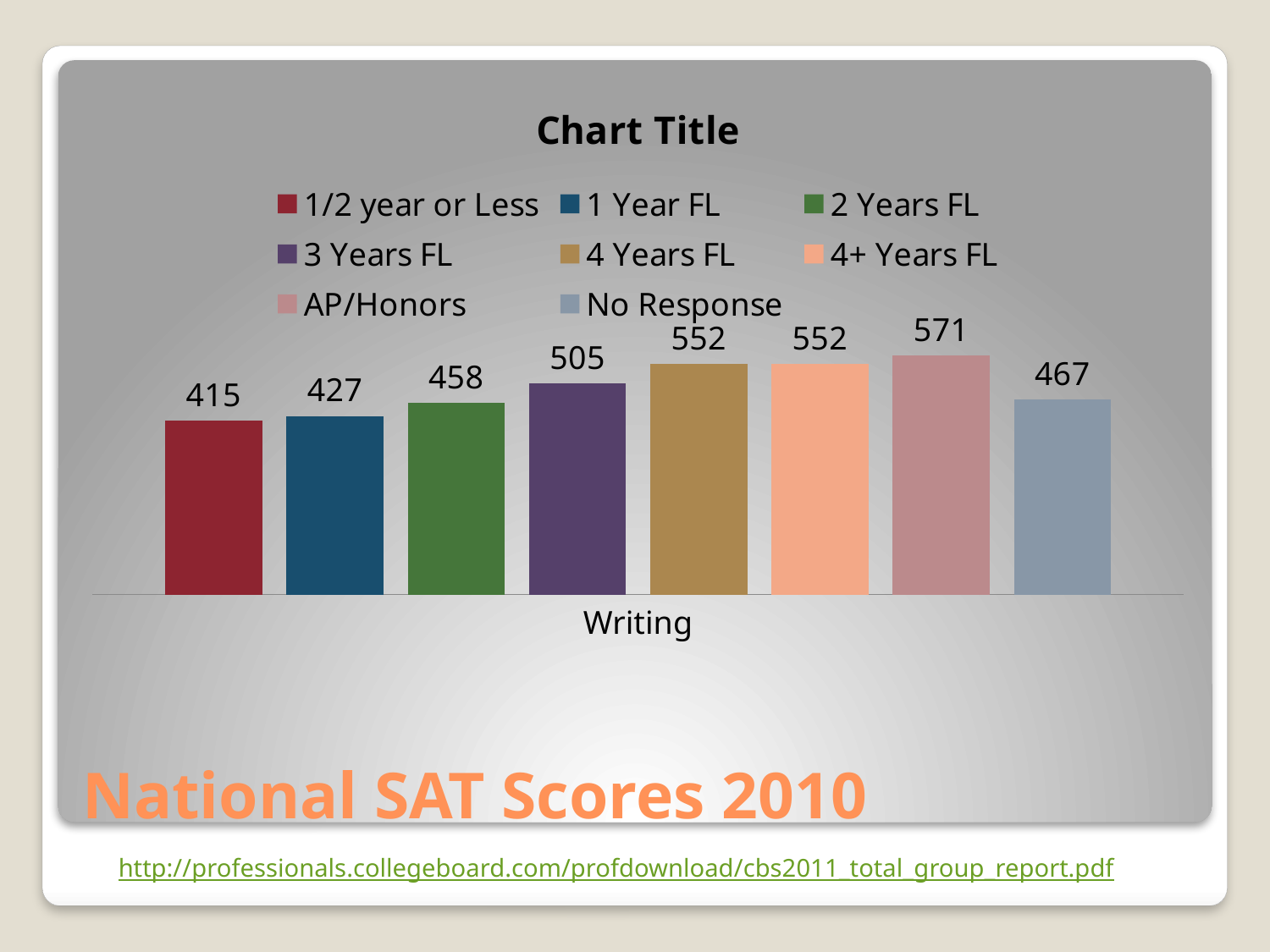
What is the Writing score for the No Response series? 467 Which series has the highest Writing score? AP/Honors What is the Writing score for the AP/Honors series? 571 What is the difference between the AP/Honors score and the 1/2 year or Less score? 156 What kind of chart is shown on the slide? Bar chart What is the category label shown on the x axis? Writing What is the Writing score for the 3 Years FL series? 505 What is the Writing score for the 1/2 year or Less series? 415 What is the difference between the 2 Years FL score and the 1 Year FL score? 31 How many series does the legend list? 8 Which is larger, the No Response score or the 2 Years FL score? No Response Which series has the lowest Writing score? 1/2 year or Less